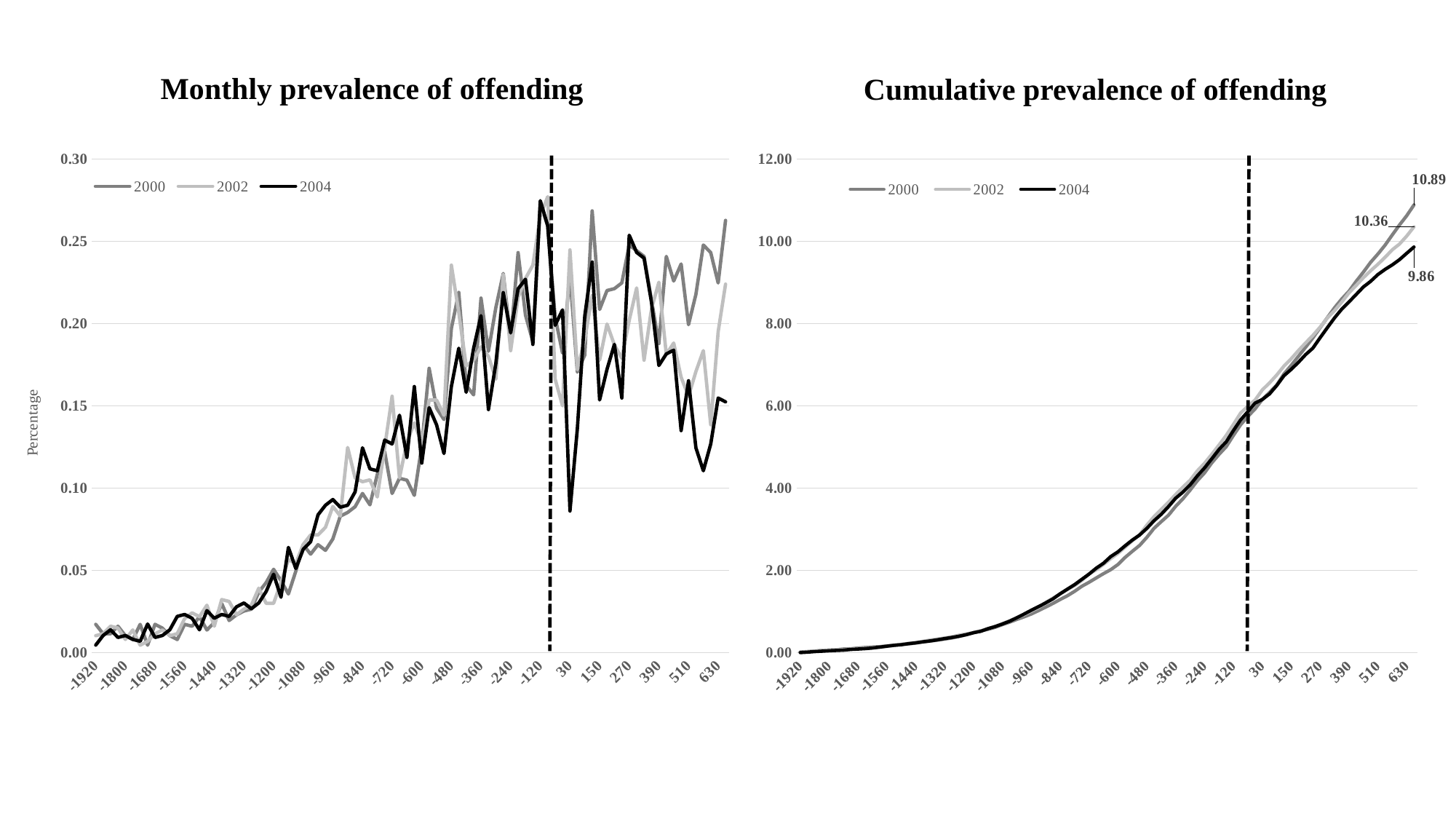
In the 'Cumulative prevalence of offending' chart, what is the difference between the final values of the 2000 and 2004 series? 1.03 What kind of chart is the 'Monthly prevalence of offending' chart? line chart In the 'Cumulative prevalence of offending' chart, which series has the highest final value? 2000 In the 'Cumulative prevalence of offending' chart, what is the final labelled value for the 2002 series? 10.36 What is the y-axis label of the 'Monthly prevalence of offending' chart? Percentage In the 'Cumulative prevalence of offending' chart, what is the final labelled value for the 2004 series? 9.86 In the 'Cumulative prevalence of offending' chart, what is the final labelled value for the 2000 series? 10.89 In the 'Cumulative prevalence of offending' chart, which series has the lowest final value? 2004 In the 'Cumulative prevalence of offending' chart, which series ends higher, 2002 or 2004? 2002 In the 'Monthly prevalence of offending' chart, is the value for the 2004 series at -1920 greater or less than 0.05? less In the 'Cumulative prevalence of offending' chart, do the values rise or fall along the x axis? rise How many series does the legend of the 'Cumulative prevalence of offending' chart list? 3